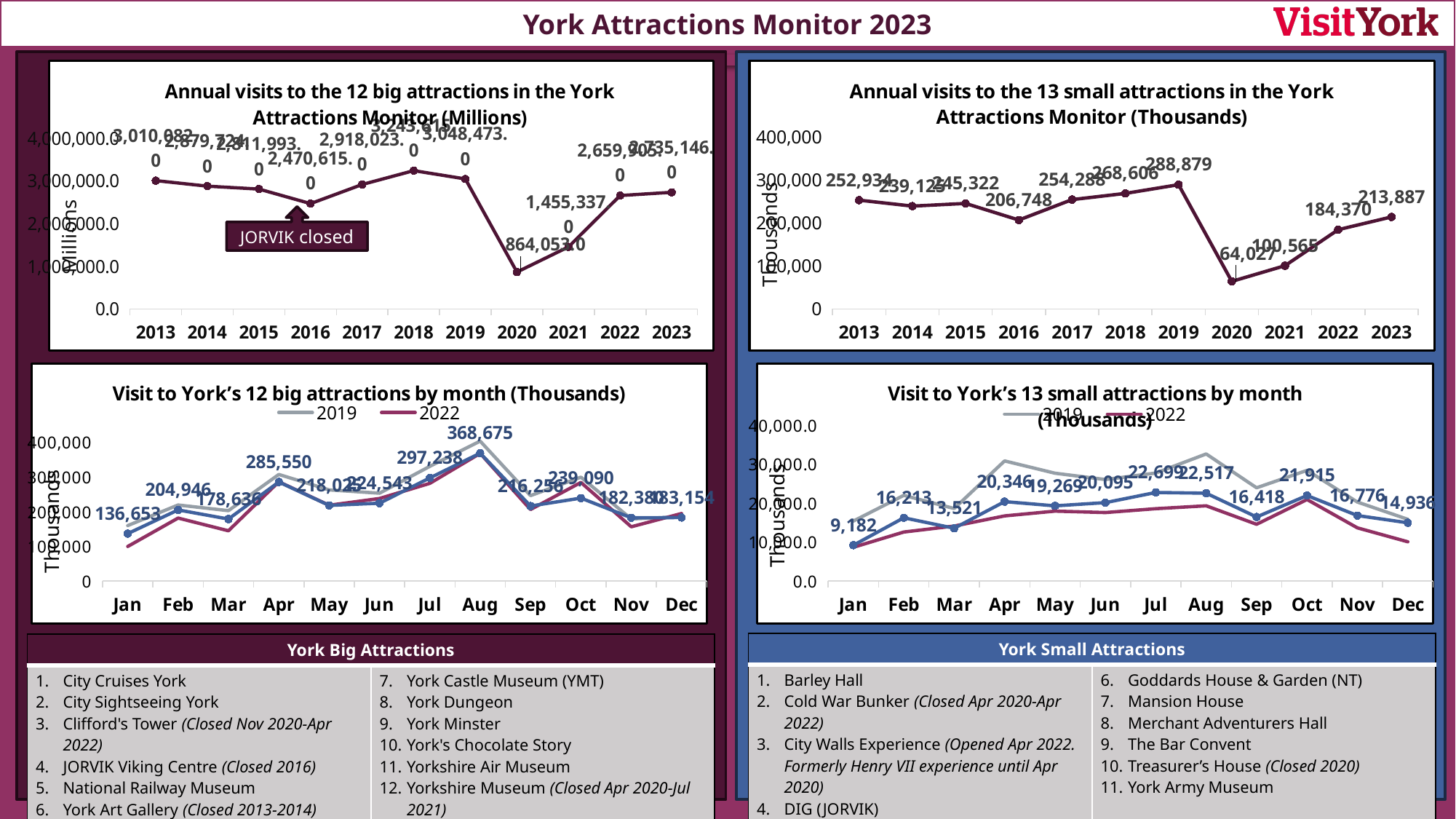
In the chart 'Annual visits to the 13 small attractions in the York Attractions Monitor (Thousands)', what is the value for 2019? 288,879 In the chart 'Annual visits to the 13 small attractions in the York Attractions Monitor (Thousands)', which year has the highest value? 2019 In the chart 'Annual visits to the 12 big attractions in the York Attractions Monitor (Millions)', what is the value for 2020? 864,053.0 In the chart 'Annual visits to the 12 big attractions in the York Attractions Monitor (Millions)', what event does the annotation at 2016 refer to? JORVIK closed In the chart 'Visit to York's 12 big attractions by month (Thousands)', how many series does the legend list? 2 In the chart 'Annual visits to the 13 small attractions in the York Attractions Monitor (Thousands)', what is the difference between the 2023 value and the 2022 value? 29,517 In the chart 'Annual visits to the 12 big attractions in the York Attractions Monitor (Millions)', which year has the lowest value? 2020 In the chart 'Visit to York's 12 big attractions by month (Thousands)', which month has the highest labelled value? Aug In the chart 'Annual visits to the 12 big attractions in the York Attractions Monitor (Millions)', what is the value for 2016? 2,470,615.0 In the chart 'Visit to York's 13 small attractions by month (Thousands)', what is the labelled value for Jan? 9,182 In the chart 'Annual visits to the 13 small attractions in the York Attractions Monitor (Thousands)', how many years are plotted on the x axis? 11 In the chart 'Annual visits to the 13 small attractions in the York Attractions Monitor (Thousands)', what is the value for 2020? 64,027